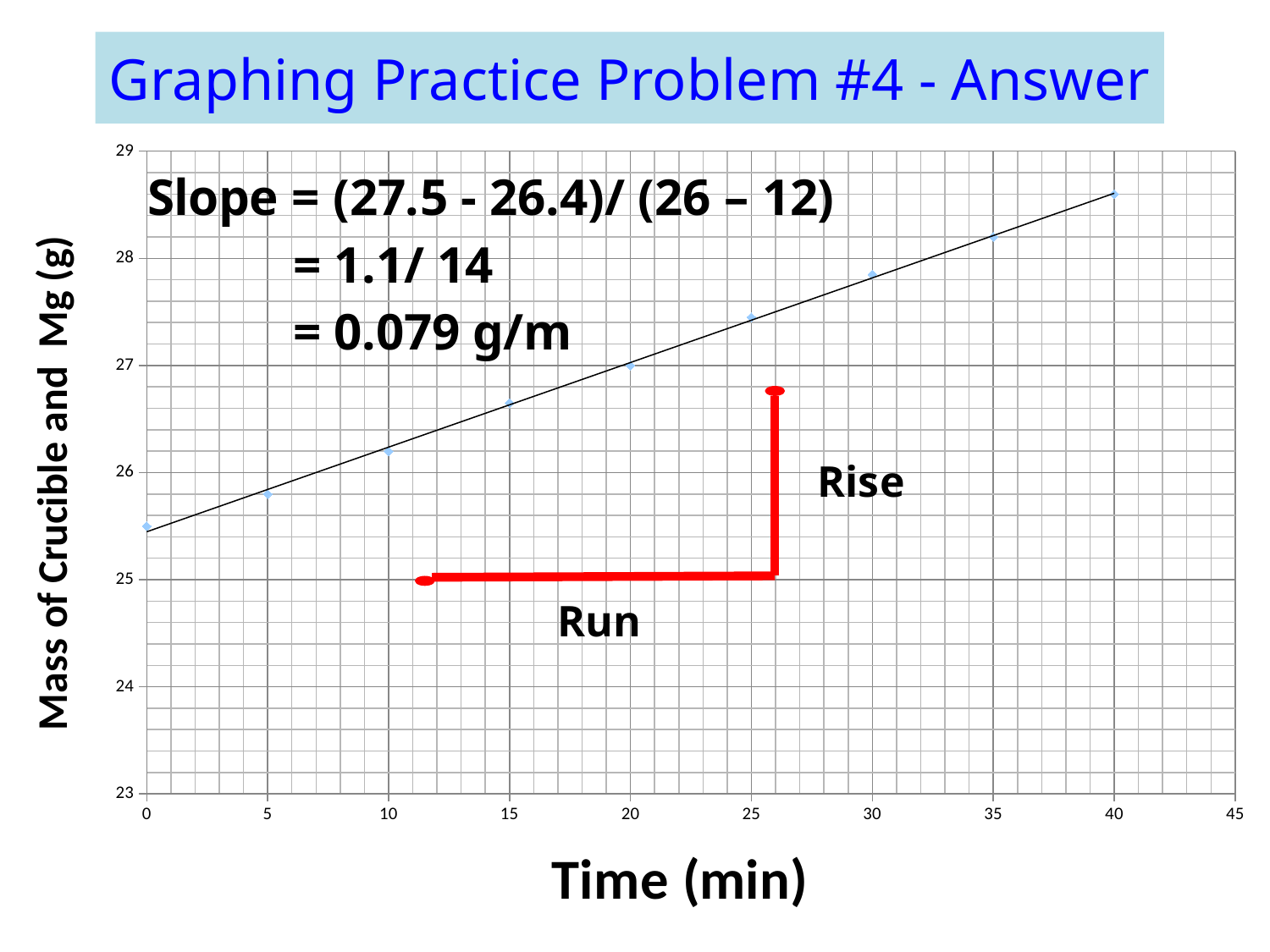
Is the value at 0 min greater or less than 25? greater Is the value at 30 min greater or less than 28? less At which time is the mass of crucible and Mg highest? 40 min What is the title of the x axis? Time (min) At which time is the mass of crucible and Mg lowest? 0 min Is the value at 5 min greater or less than 26? less What kind of chart is shown on the slide? scatter plot with a trend line Do the plotted values rise or fall as time increases along the x axis? rise Which is larger, the value at 35 min or the value at 15 min? 35 min How many data points are plotted on the chart? 9 What slope value is written on the chart? 0.079 g/m